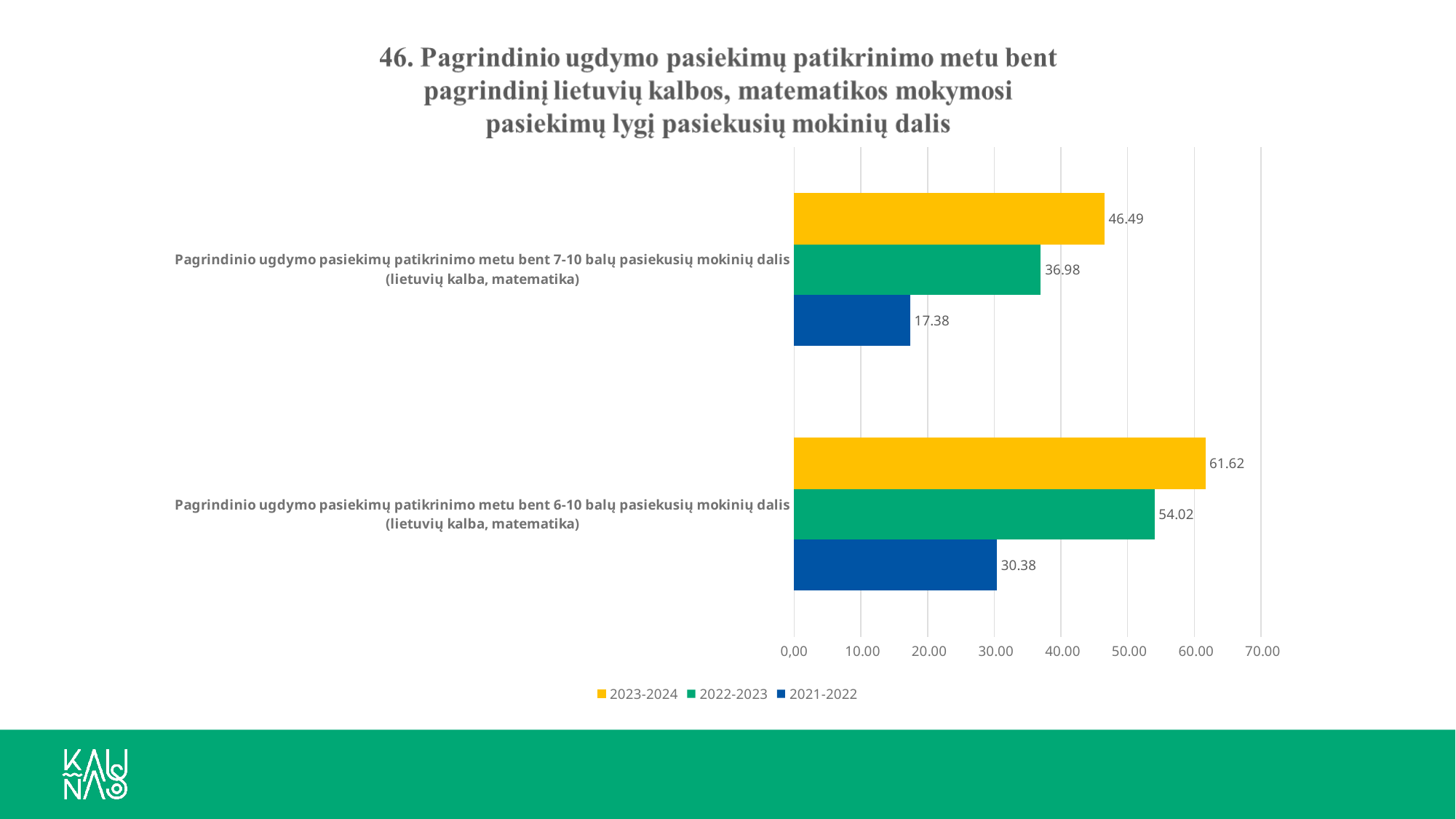
Which is larger: the 2021-2022 value for "bent 6-10 balų" or the 2022-2023 value for "bent 7-10 balų"? 2022-2023 value for "bent 7-10 balų" (36.98) What is the difference between the 2022-2023 and 2021-2022 values in the category "bent 7-10 balų pasiekusių mokinių dalis"? 19.60 What is the value for 2023-2024 in the category "bent 7-10 balų pasiekusių mokinių dalis"? 46.49 What kind of chart is shown on the slide? Bar chart How many series does the legend list? 3 Is the 2023-2024 value for "bent 6-10 balų pasiekusių mokinių dalis" greater or less than 60.00? greater Which series has the lowest value in the category "bent 7-10 balų pasiekusių mokinių dalis"? 2021-2022 What is the difference between the 2023-2024 and 2022-2023 values in the category "bent 6-10 balų pasiekusių mokinių dalis"? 7.60 What is the value for 2022-2023 in the category "bent 7-10 balų pasiekusių mokinių dalis"? 36.98 What is the value for 2021-2022 in the category "bent 6-10 balų pasiekusių mokinių dalis"? 30.38 Which series has the highest value in the category "bent 6-10 balų pasiekusių mokinių dalis"? 2023-2024 Which colour represents the 2021-2022 series? Blue